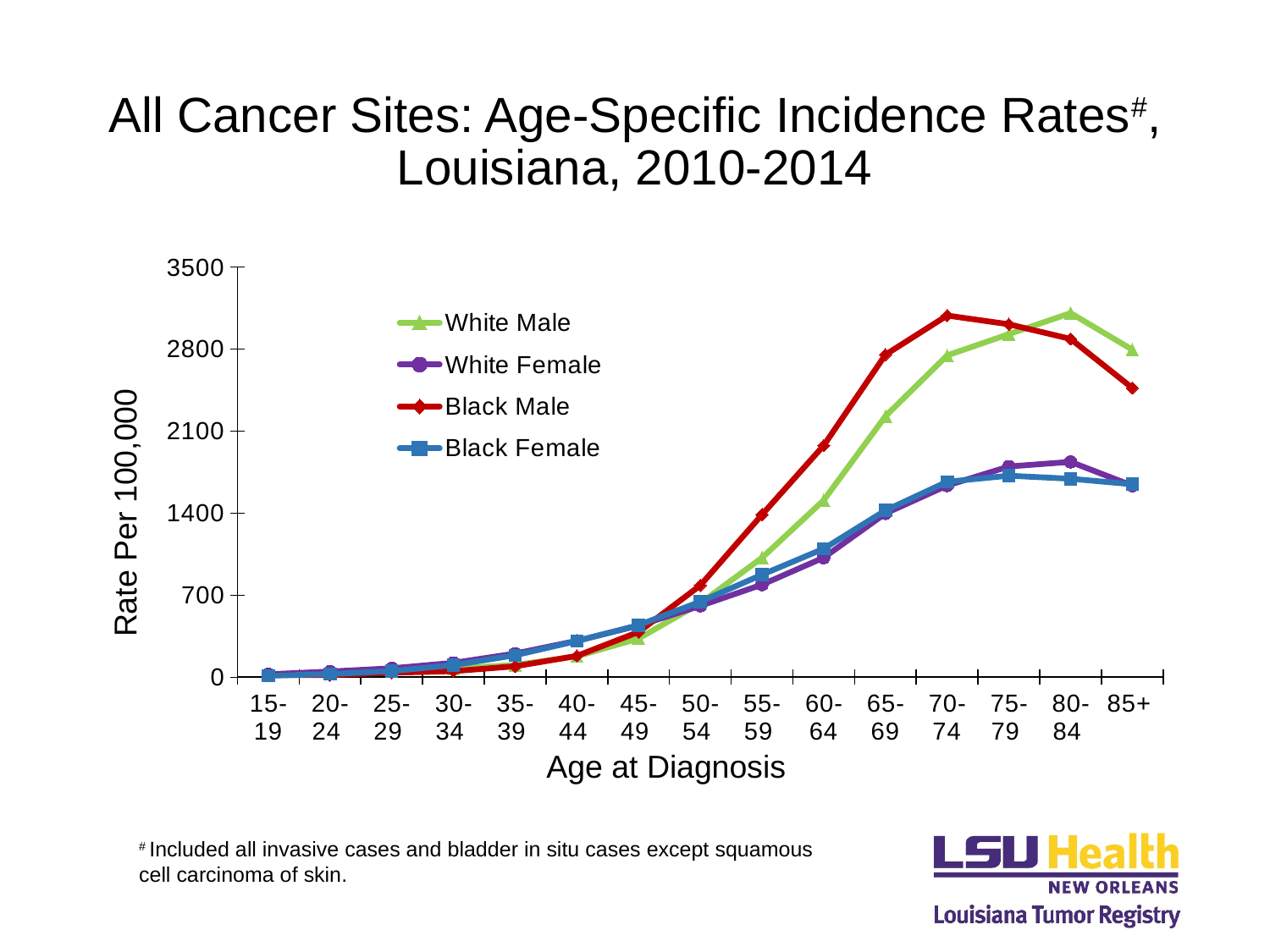
Which age group has the lowest value for the Black Male series? 15-19 Is the Black Male value for the 70-74 age group greater or less than 2800? greater Is the White Female value for the 85+ age group greater or less than 1400? greater How many series does the legend list? 4 At which age group does the White Male series reach its highest value? 80-84 Is the Black Male value for the 45-49 age group greater or less than 700? less At the 85+ age group, which is larger: the White Male value or the Black Male value? White Male What is the title of the y axis? Rate Per 100,000 Does the Black Male series rise or fall from the 70-74 age group to the 85+ age group? fall How many age groups are plotted along the x axis? 15 What kind of chart is shown on the slide? line chart At which age group does the Black Male series reach its highest value? 70-74